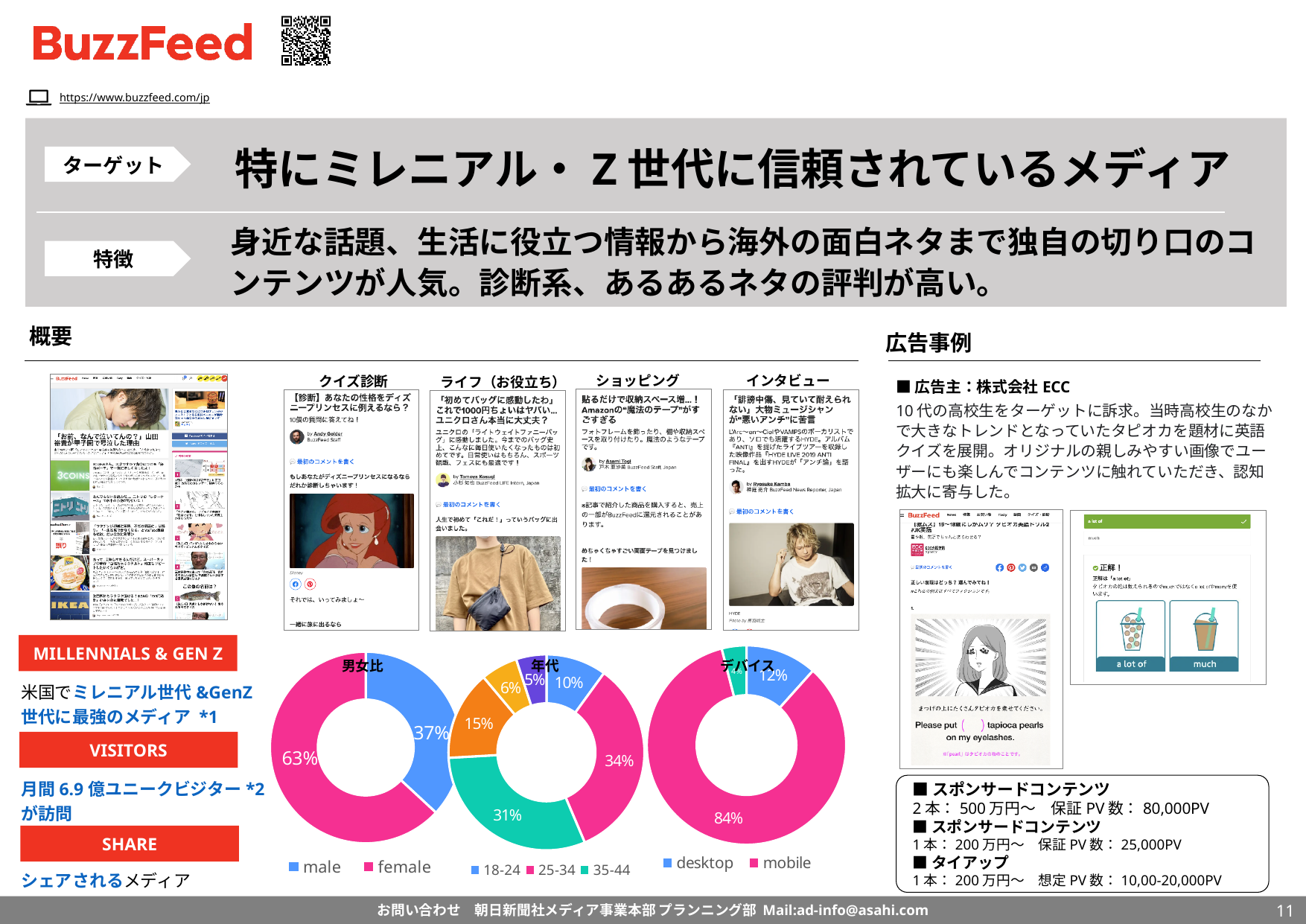
In the 年代 chart, how many entries does the legend list? 3 In the 年代 chart, what percentage is the 18-24 group? 10% In the 男女比 chart, which is larger, male or female? female In the デバイス chart, what percentage is mobile? 84% In the 男女比 chart, what percentage is female? 63% In the 男女比 chart, what percentage is male? 37% In the 年代 chart, what percentage is the 25-34 group? 34% What kind of chart is the デバイス chart? donut (pie) chart In the 年代 chart, what percentage is the 35-44 group? 31% In the デバイス chart, which is larger, desktop or mobile? mobile In the 男女比 chart, what is the difference in percentage points between female and male? 26 In the デバイス chart, what percentage is desktop? 12%